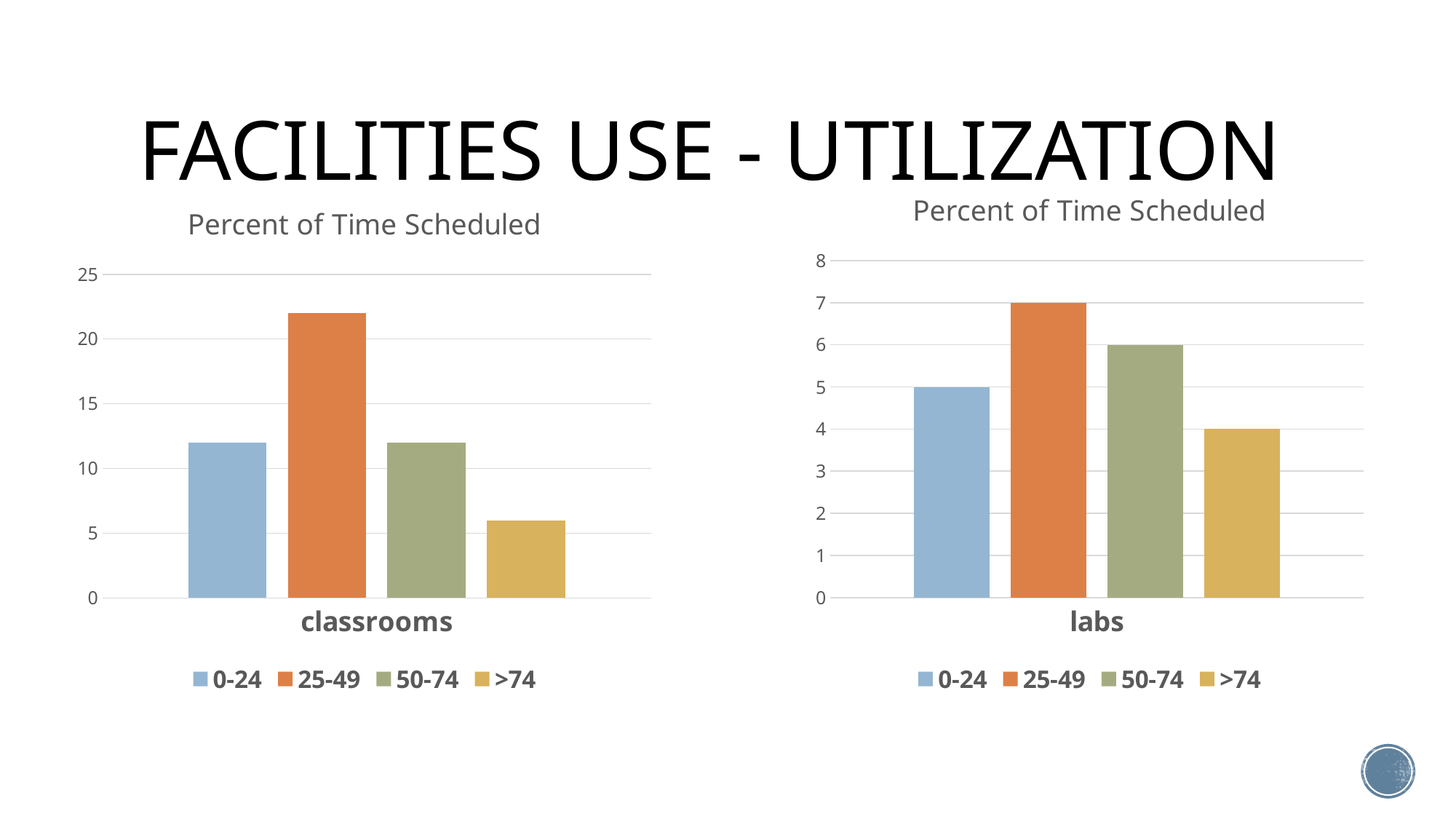
In the right-hand chart (labs), what is the value for the >74 series? 4 In the right-hand chart (labs), which series has the lowest value? >74 In the left-hand chart (classrooms), which series has the highest value? 25-49 In the left-hand chart (classrooms), is the value for 25-49 greater or less than 20? greater In the left-hand chart (classrooms), is the value for >74 greater or less than 10? less How many series does the legend of the left-hand chart (classrooms) list? 4 In the right-hand chart (labs), what is the difference between the 25-49 value and the >74 value? 3 What type of chart is the right-hand chart (labs)? bar chart In the left-hand chart (classrooms), which series has the lowest value? >74 In the right-hand chart (labs), what is the value for the 0-24 series? 5 In the right-hand chart (labs), what is the value for the 25-49 series? 7 In the right-hand chart (labs), which series has the highest value? 25-49